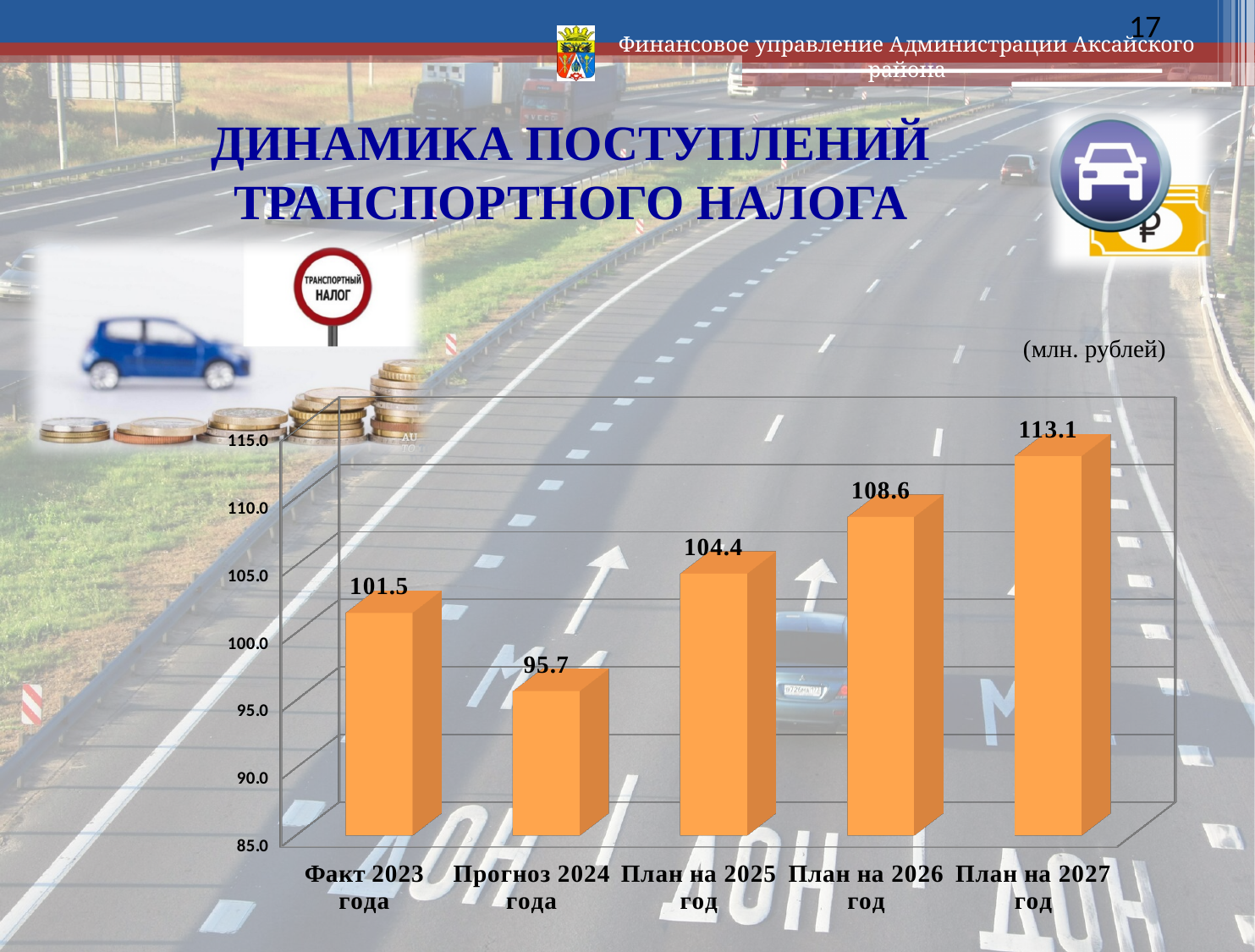
Which category has the lowest value? Прогноз 2024 года What kind of chart is shown on the slide? bar chart Which category has the highest value? План на 2027 год What is the difference between the values for План на 2027 год and Факт 2023 года? 11.6 What is the value for Факт 2023 года? 101.5 Which is larger, the value for Факт 2023 года or the value for Прогноз 2024 года? Факт 2023 года What is the value for Прогноз 2024 года? 95.7 How many categories are shown on the chart? 5 Is the value for План на 2025 год greater or less than 100.0? greater What unit is indicated for the chart values? млн. рублей What is the difference between the values for План на 2026 год and План на 2025 год? 4.2 What is the value for План на 2027 год? 113.1